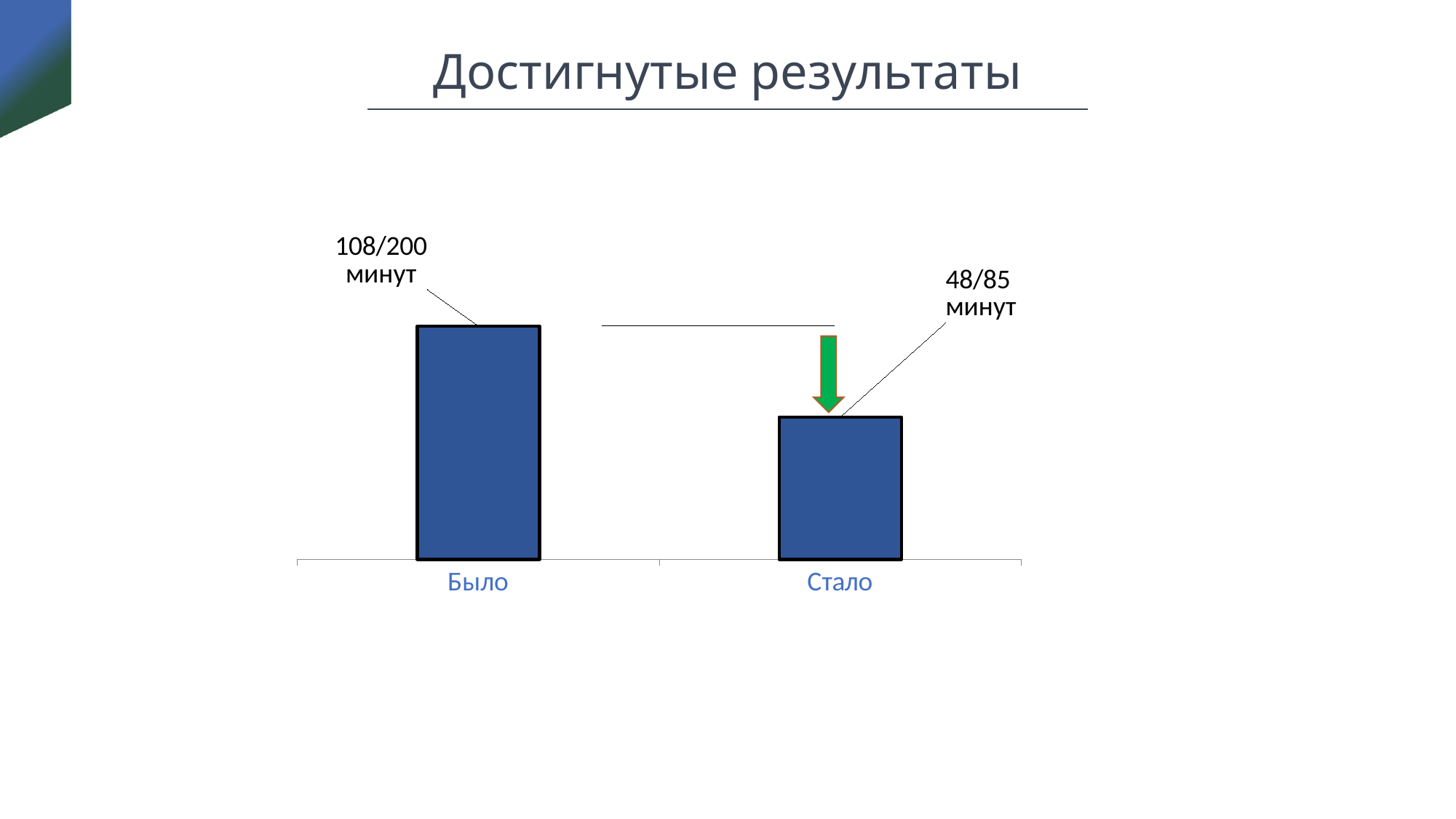
What are the two category labels on the x axis of the chart? Было, Стало How many bars are plotted in the chart? 2 What is the title of the slide containing the chart? Достигнутые результаты What is the data label shown for the "Было" bar? 108/200 минут Which category has the taller bar? Было Is the bar for "Было" taller or shorter than the bar for "Стало"? taller What kind of chart is shown on the slide? bar chart Do the bar values rise or fall from "Было" to "Стало"? fall What is the data label shown for the "Стало" bar? 48/85 минут Which category has the shorter bar? Стало